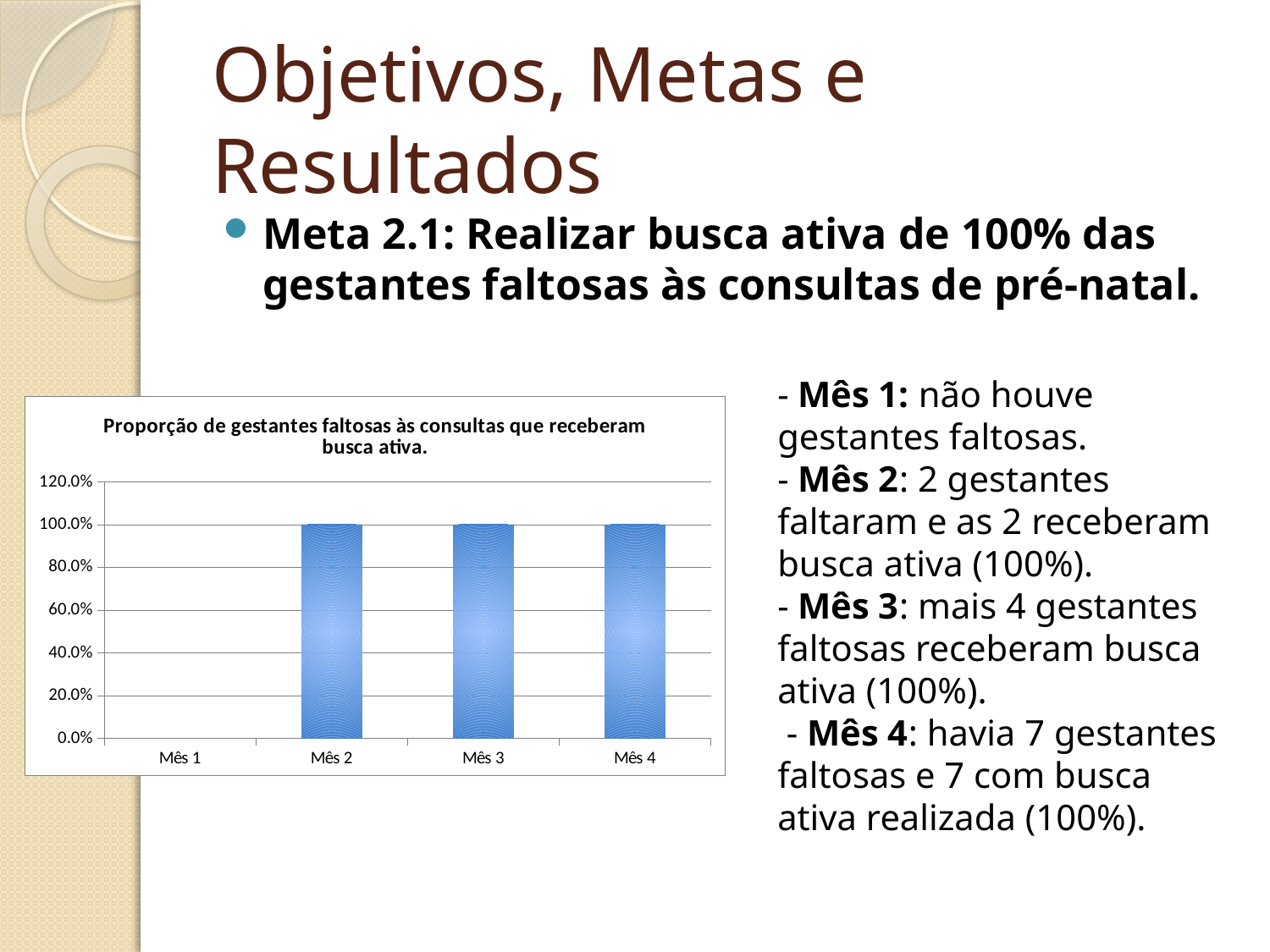
What is the value for Mês 4 in the chart? 100.0% What is the title of the chart? Proporção de gestantes faltosas às consultas que receberam busca ativa. Which is larger, the value for Mês 1 or the value for Mês 2? Mês 2 What is the highest tick value shown on the chart's y axis? 120.0% What kind of chart is shown on the slide? Bar chart Is the value for Mês 3 greater or less than 80.0%? greater Is the value for Mês 1 greater or less than 20.0%? less What is the difference between the values for Mês 3 and Mês 2? 0.0% Which month has the lowest value in the chart? Mês 1 Do the values change between Mês 2 and Mês 4? No, they stay the same What is the value for Mês 2 in the chart? 100.0% How many categories (months) are shown on the x axis of the chart? 4